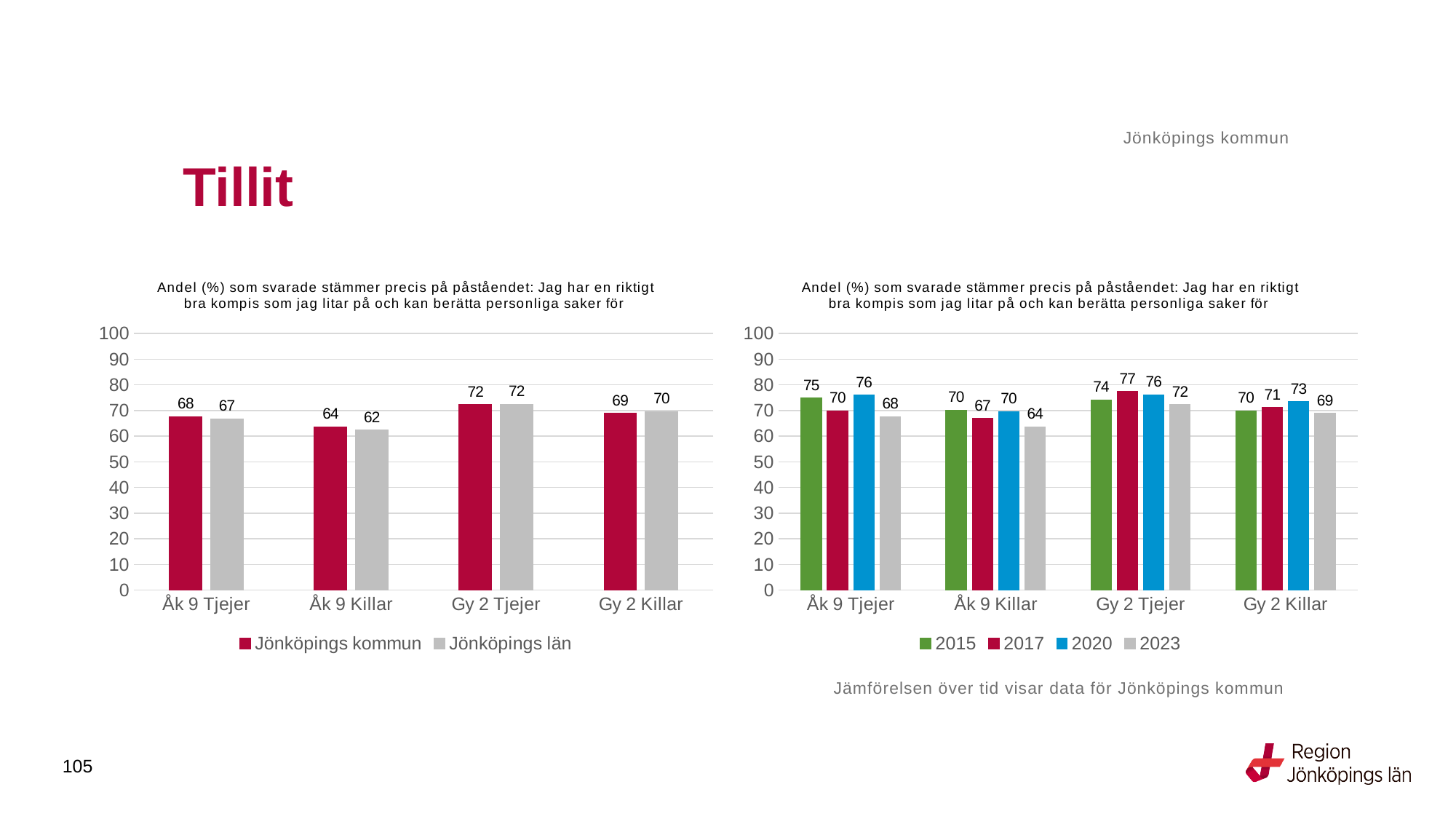
In the left chart, which category has the lowest value for Jönköpings kommun? Åk 9 Killar In the left chart, how many series does the legend list? 2 In the right chart, what is the value for 2023 for Åk 9 Killar? 64 In the left chart, what is the value for Jönköpings kommun for Åk 9 Tjejer? 68 What kind of chart is the left chart? Bar chart In the right chart, what is the difference between the 2015 and 2023 values for Åk 9 Tjejer? 7 In the right chart, is the 2020 value for Gy 2 Killar larger or smaller than the 2023 value for Gy 2 Killar? larger In the left chart, what is the value for Jönköpings län for Åk 9 Killar? 62 In the right chart, how many series does the legend list? 4 In the right chart, what is the value for 2017 for Gy 2 Tjejer? 77 In the right chart, which year has the highest value for Åk 9 Tjejer? 2020 In the left chart, what is the difference between Jönköpings kommun and Jönköpings län for Åk 9 Tjejer? 1